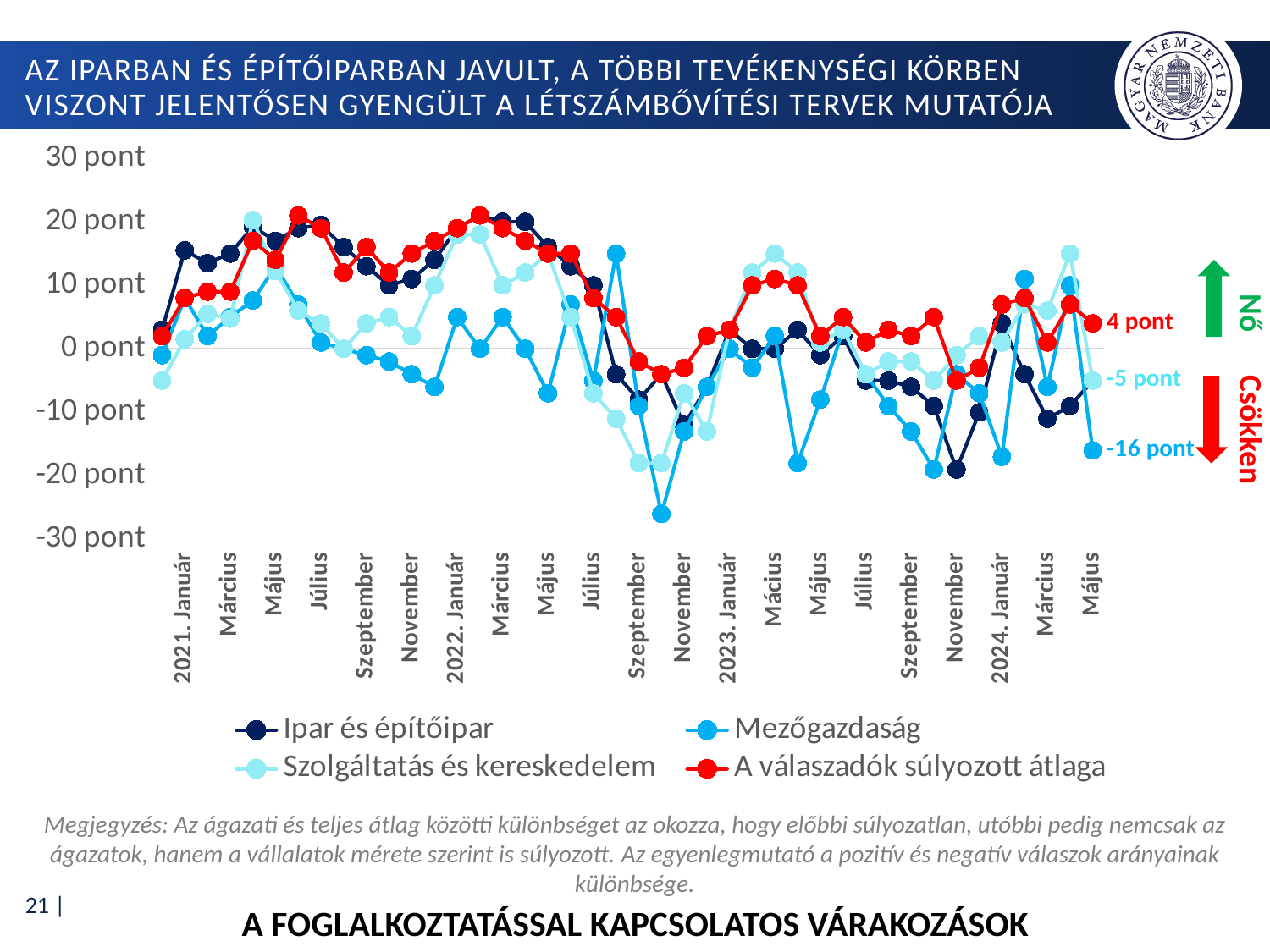
Which series reaches the lowest value anywhere on the chart? Mezőgazdaság What is the last labelled value of the 'Mezőgazdaság' series? -16 pont What is the difference between the final labelled values of 'A válaszadók súlyozott átlaga' (4 pont) and 'Mezőgazdaság' (-16 pont)? 20 pont At the final labelled point, which is higher: 'Mezőgazdaság' or 'Szolgáltatás és kereskedelem'? Szolgáltatás és kereskedelem What is the last labelled value of the 'A válaszadók súlyozott átlaga' series? 4 pont Is the value for 'Ipar és építőipar' in Március 2022 greater or less than 10 pont? greater What kind of chart is shown on the slide? line chart What is the difference between the final labelled values of 'Szolgáltatás és kereskedelem' (-5 pont) and 'Mezőgazdaság' (-16 pont)? 11 pont How many series does the legend list? 4 What is the last labelled value of the 'Szolgáltatás és kereskedelem' series? -5 pont What colour is the line for 'A válaszadók súlyozott átlaga'? red Is the lowest value reached by the 'Mezőgazdaság' series greater or less than -20 pont? less